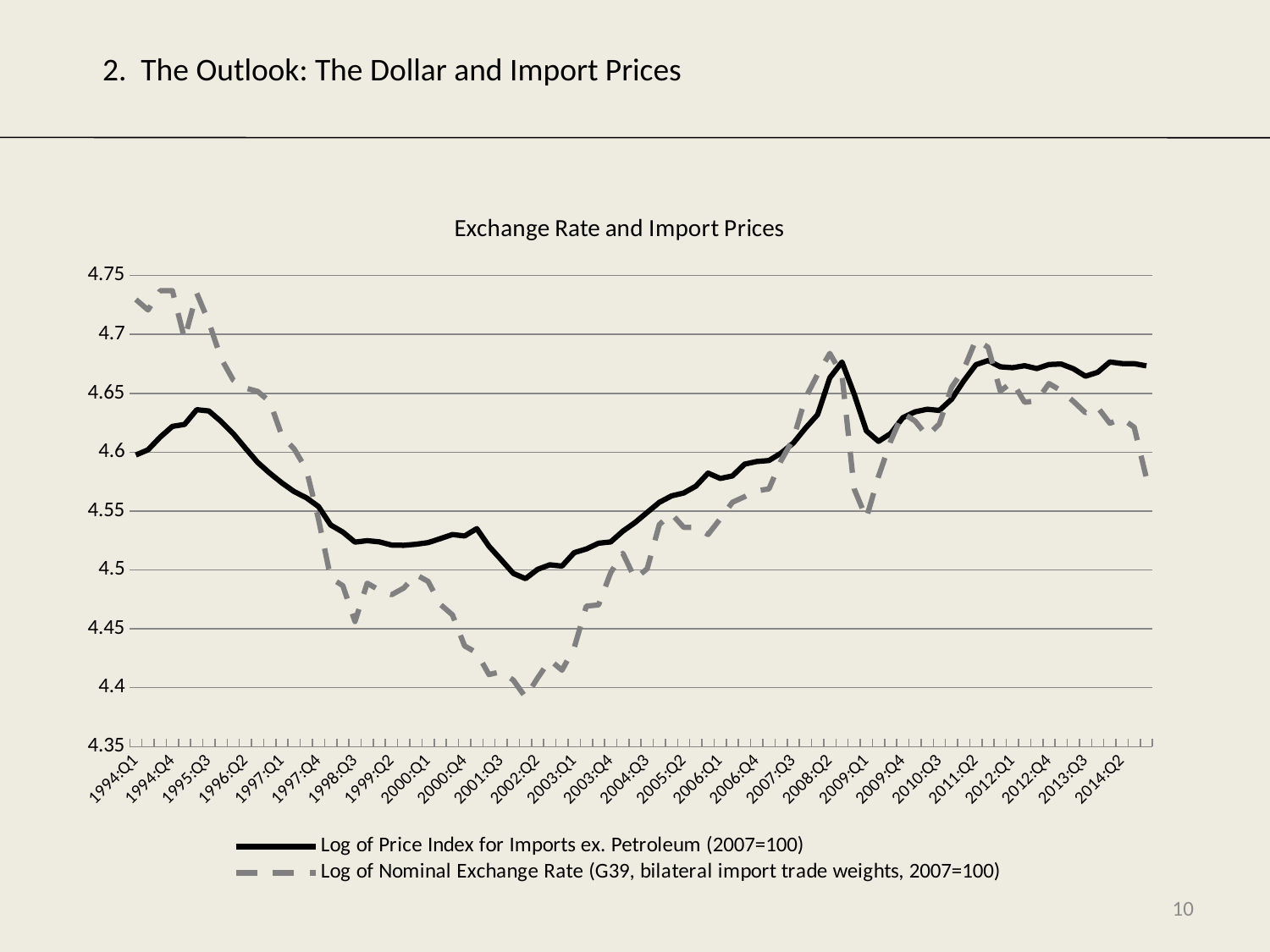
Which series is drawn with a dashed line? Log of Nominal Exchange Rate (G39, bilateral import trade weights, 2007=100) Does the Log of Price Index for Imports ex. Petroleum rise or fall between 1995:Q3 and 2002:Q2? fall How many series does the legend list? 2 Is the value of the Log of Price Index for Imports ex. Petroleum at 2014:Q2 greater or less than 4.65? greater At 1994:Q4, which series has the higher value? Log of Nominal Exchange Rate (G39, bilateral import trade weights, 2007=100) Is the value of the Log of Price Index for Imports ex. Petroleum at 2002:Q2 greater or less than 4.55? less Is the value of the Log of Nominal Exchange Rate at 2002:Q2 greater or less than 4.45? less Does the Log of Price Index for Imports ex. Petroleum rise or fall between 2002:Q2 and 2008:Q2? rise What kind of chart is shown on the slide? Line chart What is the title of the chart? Exchange Rate and Import Prices At 2002:Q2, which series has the higher value? Log of Price Index for Imports ex. Petroleum (2007=100)